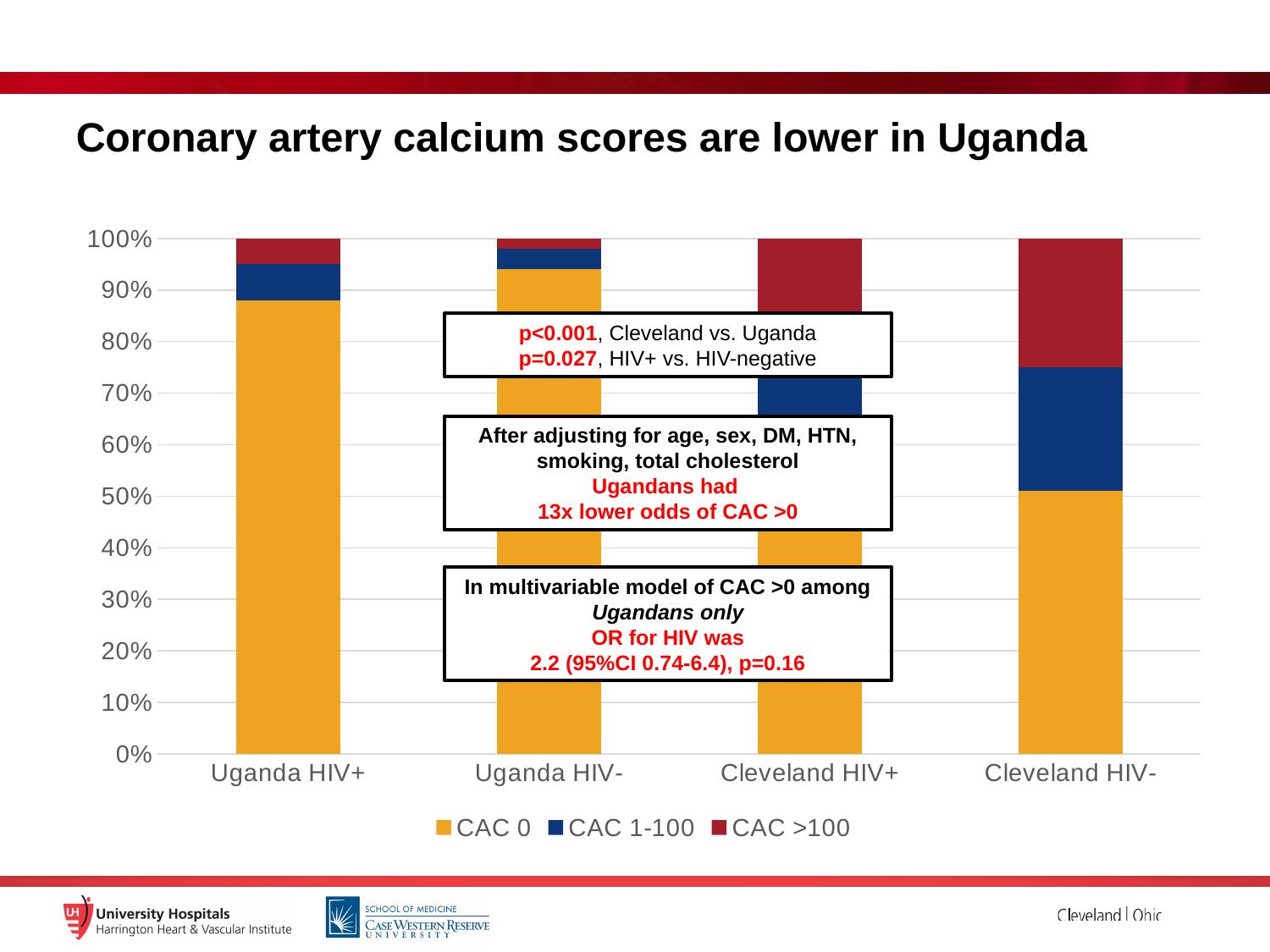
How many series does the chart legend list? 3 Is the CAC 0 share for Cleveland HIV- greater or less than 60%? less Which category has the largest CAC 0 share? Uganda HIV- Is the CAC 0 share for Uganda HIV+ greater or less than 80%? greater Which colour represents the CAC >100 series in the chart? Red Which has the larger CAC 0 share, Uganda HIV+ or Uganda HIV-? Uganda HIV- What kind of chart is shown on the slide? Stacked bar chart How many categories are shown on the x axis of the chart? 4 Is the CAC 0 share for Uganda HIV- greater or less than 90%? greater What is the title of the slide containing the chart? Coronary artery calcium scores are lower in Uganda Which category has the largest CAC >100 share? Cleveland HIV-